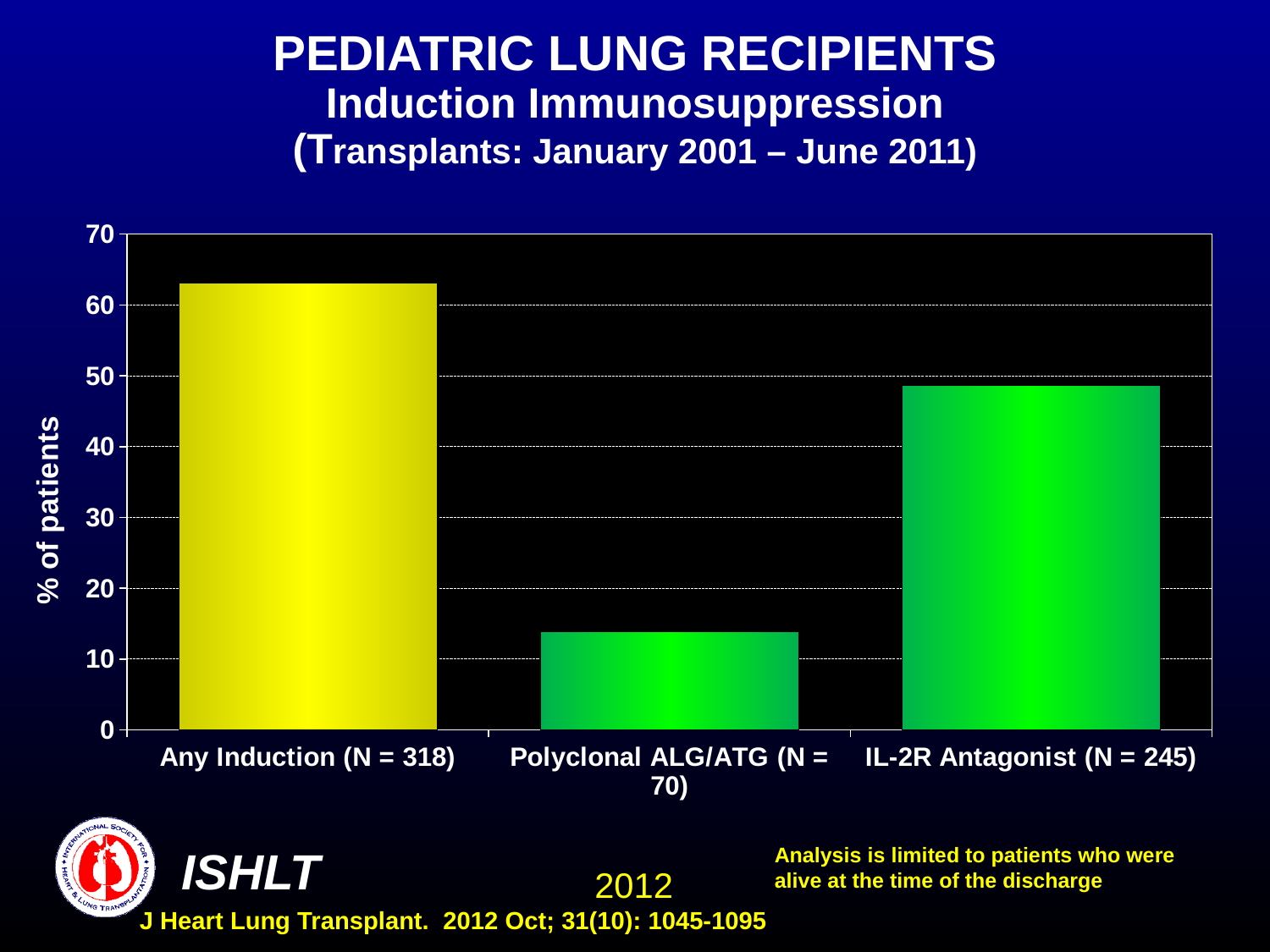
What kind of chart is shown on the slide? bar chart What transplant date range is given in the chart title? January 2001 – June 2011 Which category has the highest percentage of patients? Any Induction (N = 318) Is the value for Polyclonal ALG/ATG (N = 70) greater or less than 20? less Is the value for Any Induction (N = 318) greater or less than 60? greater How many categories are plotted on the chart? 3 Is the value for IL-2R Antagonist (N = 245) greater or less than 40? greater Which category has the lowest percentage of patients? Polyclonal ALG/ATG (N = 70) What is the label of the y axis? % of patients Which is larger, the value for IL-2R Antagonist (N = 245) or the value for Polyclonal ALG/ATG (N = 70)? IL-2R Antagonist (N = 245) Which is larger, the value for Any Induction (N = 318) or the value for IL-2R Antagonist (N = 245)? Any Induction (N = 318)